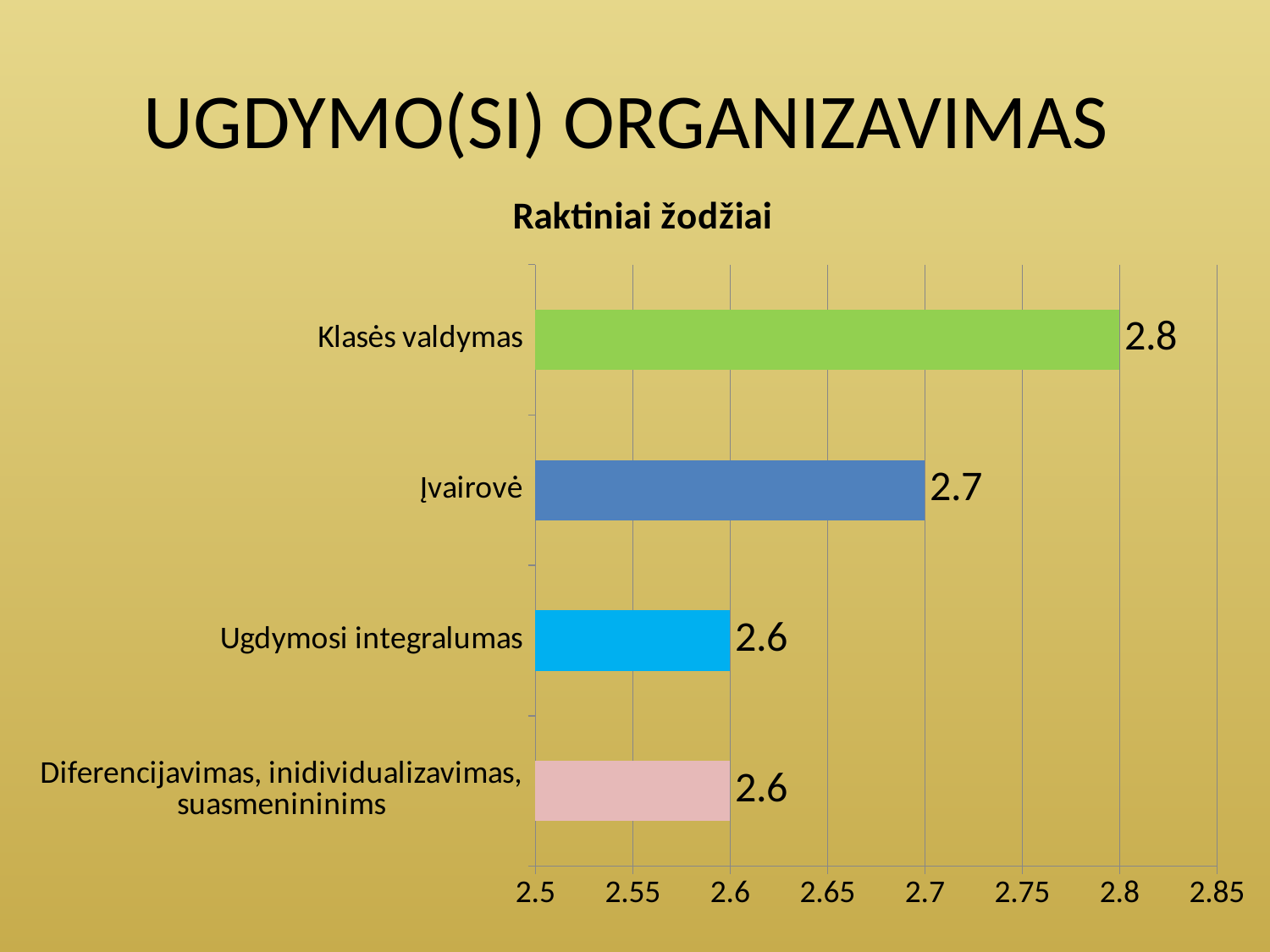
Which is larger, the value for Įvairovė or the value for Ugdymosi integralumas? Įvairovė What is the difference between the values for Klasės valdymas and Įvairovė? 0.1 What is the value for Įvairovė? 2.7 What is the title of the chart? Raktiniai žodžiai Which category has the highest value? Klasės valdymas What is the value for Ugdymosi integralumas? 2.6 What is the value for Diferencijavimas, inidividualizavimas, suasmenininims? 2.6 How many categories are shown in the chart? 4 What is the value for Klasės valdymas? 2.8 What is the difference between the values for Klasės valdymas and Ugdymosi integralumas? 0.2 Is the value for Įvairovė greater or less than 2.65? greater What kind of chart is shown on the slide? bar chart